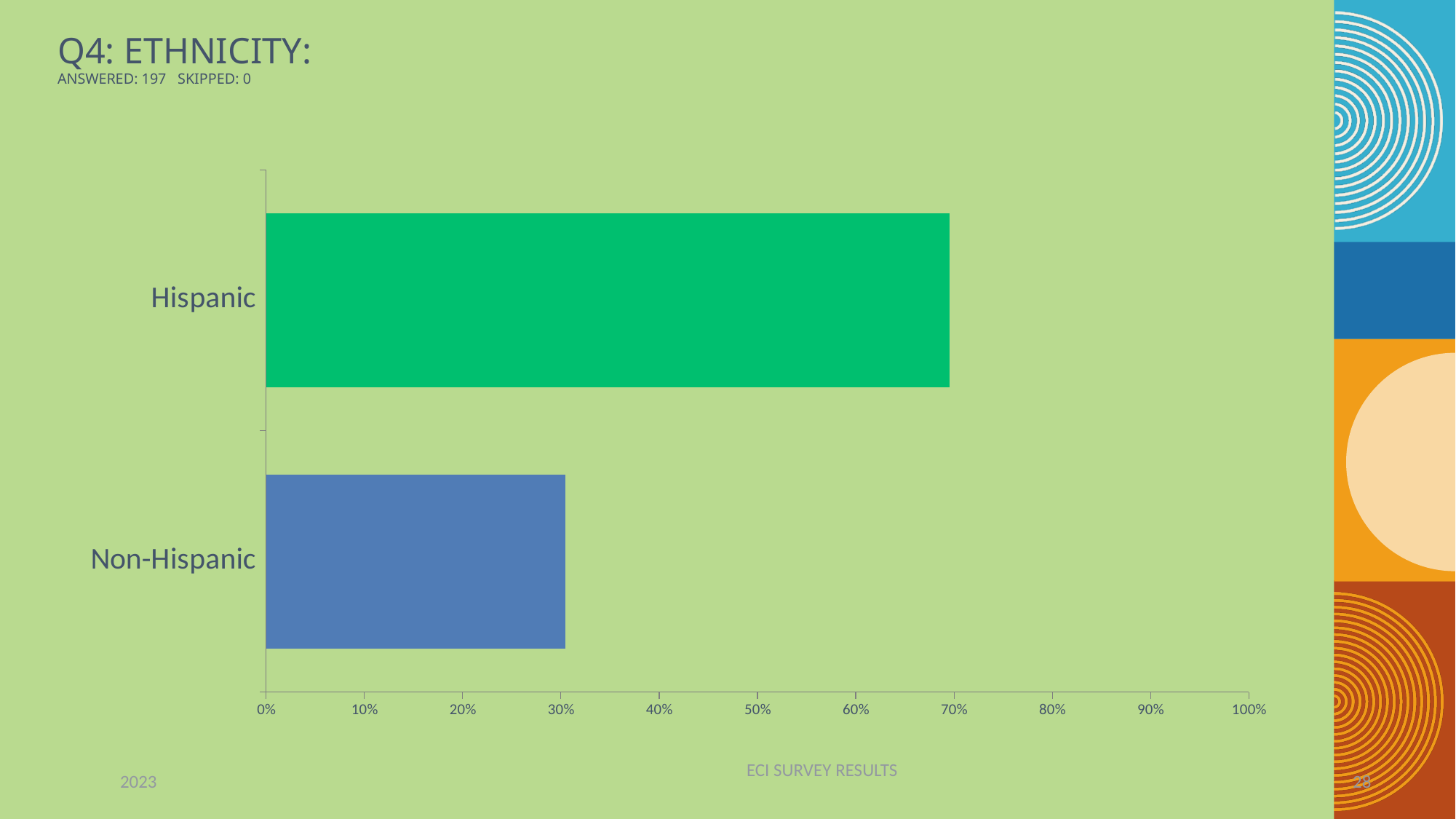
Is the value for Non-Hispanic greater or less than 20%? greater How many categories does the chart show? 2 Is the value for Hispanic greater or less than 60%? greater Which category has the lowest value? Non-Hispanic Is the value for Non-Hispanic greater or less than 40%? less What colour is the bar for Hispanic? green Which category has the highest value? Hispanic What kind of chart is shown on the slide? bar chart Which is larger, the value for Hispanic or the value for Non-Hispanic? Hispanic What is the title of the chart on the slide? Q4: ETHNICITY: